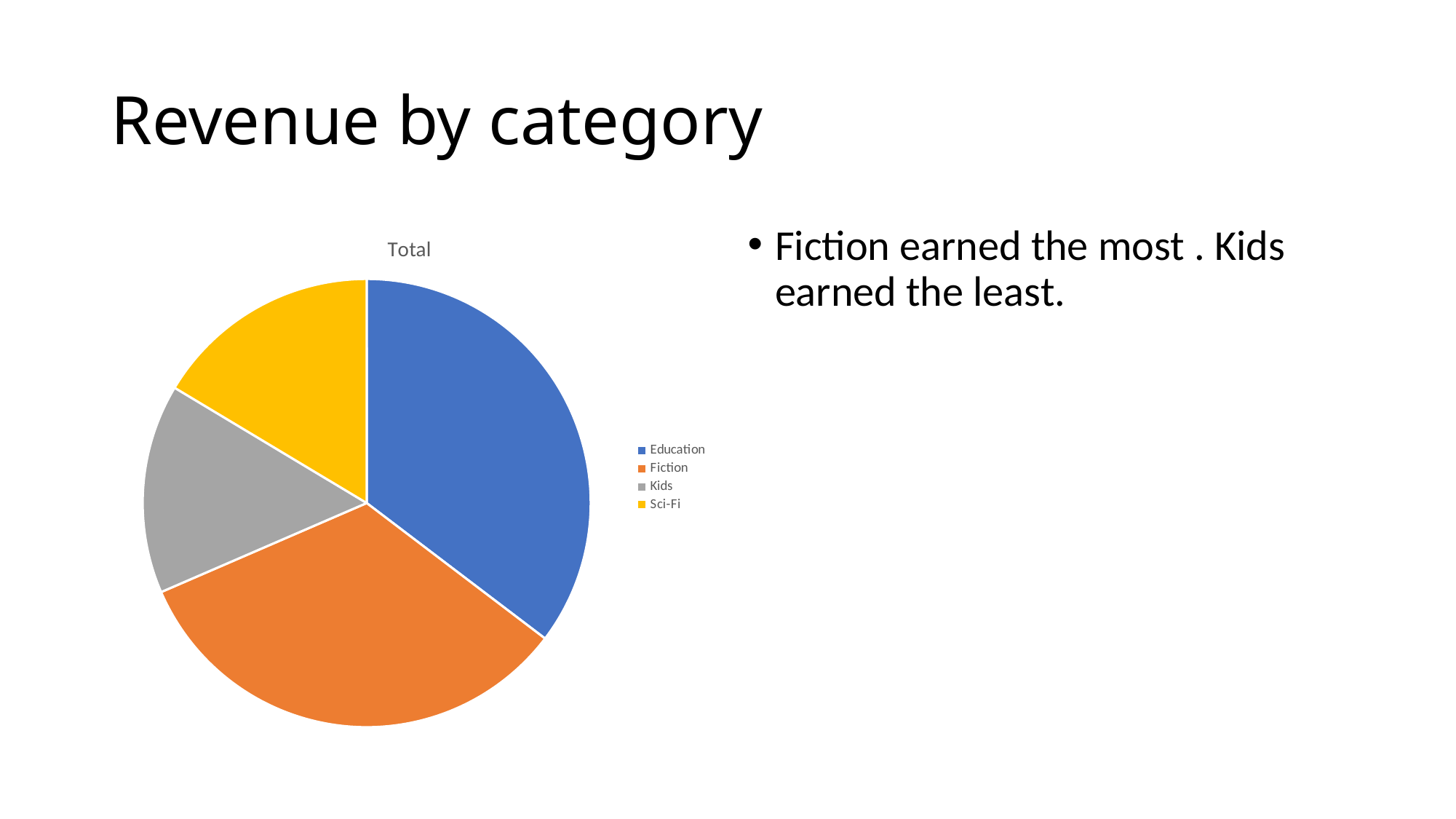
Which slice is larger, Education or Kids? Education How many categories (slices) does the pie chart have? 4 Which slice is larger, Fiction or Education? Education What colour represents Fiction in the pie chart? Orange Which slice is larger, Fiction or Sci-Fi? Fiction What kind of chart is shown on the slide? Pie chart What is the title of the chart? Total Which category has the largest slice of the pie? Education How many entries does the chart legend list? 4 Which category has the smallest slice of the pie? Kids